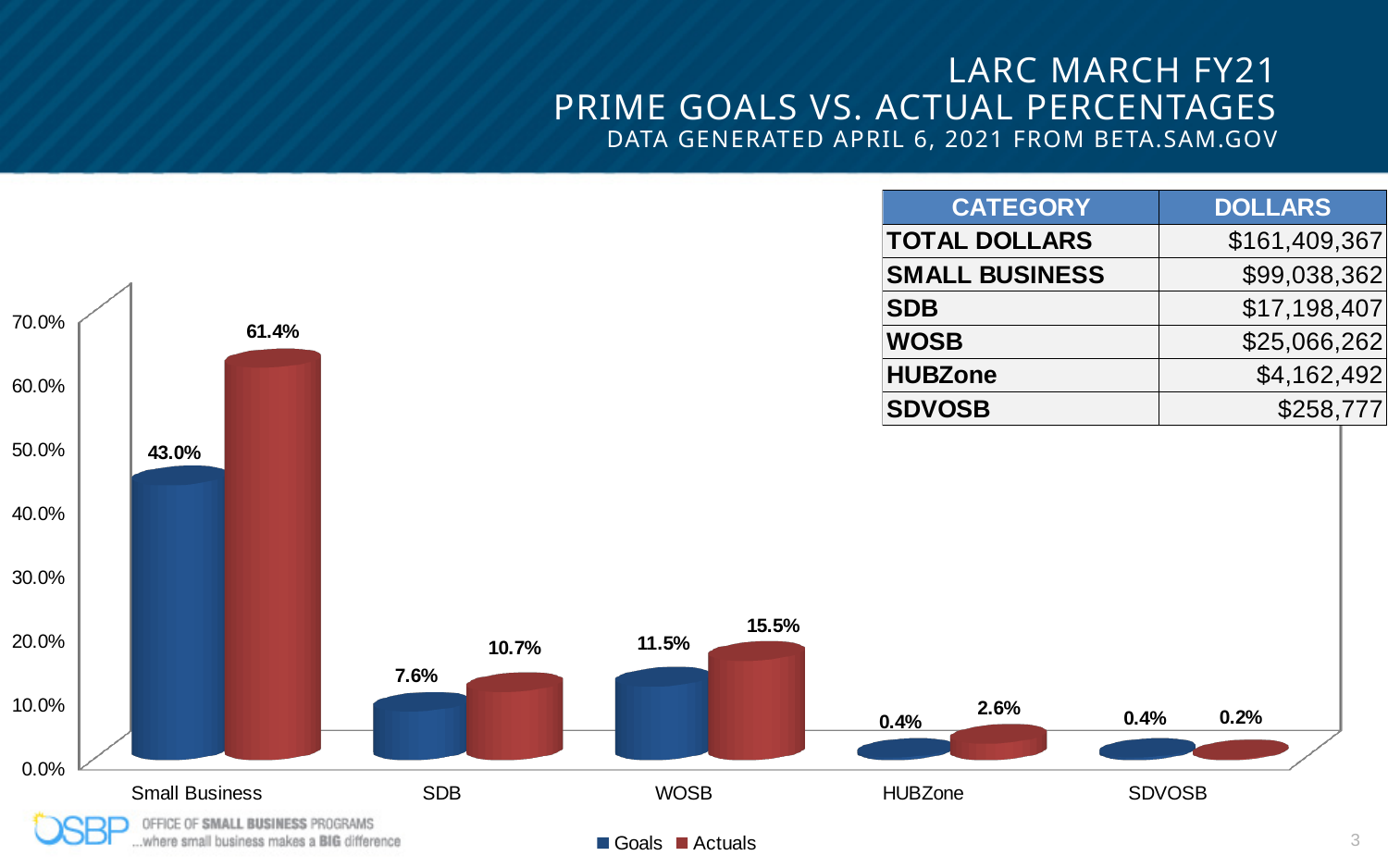
What is the Actuals value for Small Business? 61.4% What is the Goals value for WOSB? 11.5% What is the difference between the Actuals and Goals values for Small Business? 18.4% How many categories are shown on the x axis of the chart? 5 Which category has the highest Actuals value? Small Business Which is larger for SDVOSB, the Goals value or the Actuals value? Goals What is the difference between the Actuals and Goals values for SDB? 3.1% Which category has the lowest Actuals value? SDVOSB What is the Actuals value for HUBZone? 2.6% What kind of chart is shown on the slide? Bar chart Is the Actuals value for WOSB greater or less than 20.0%? less How many series does the chart legend list? 2